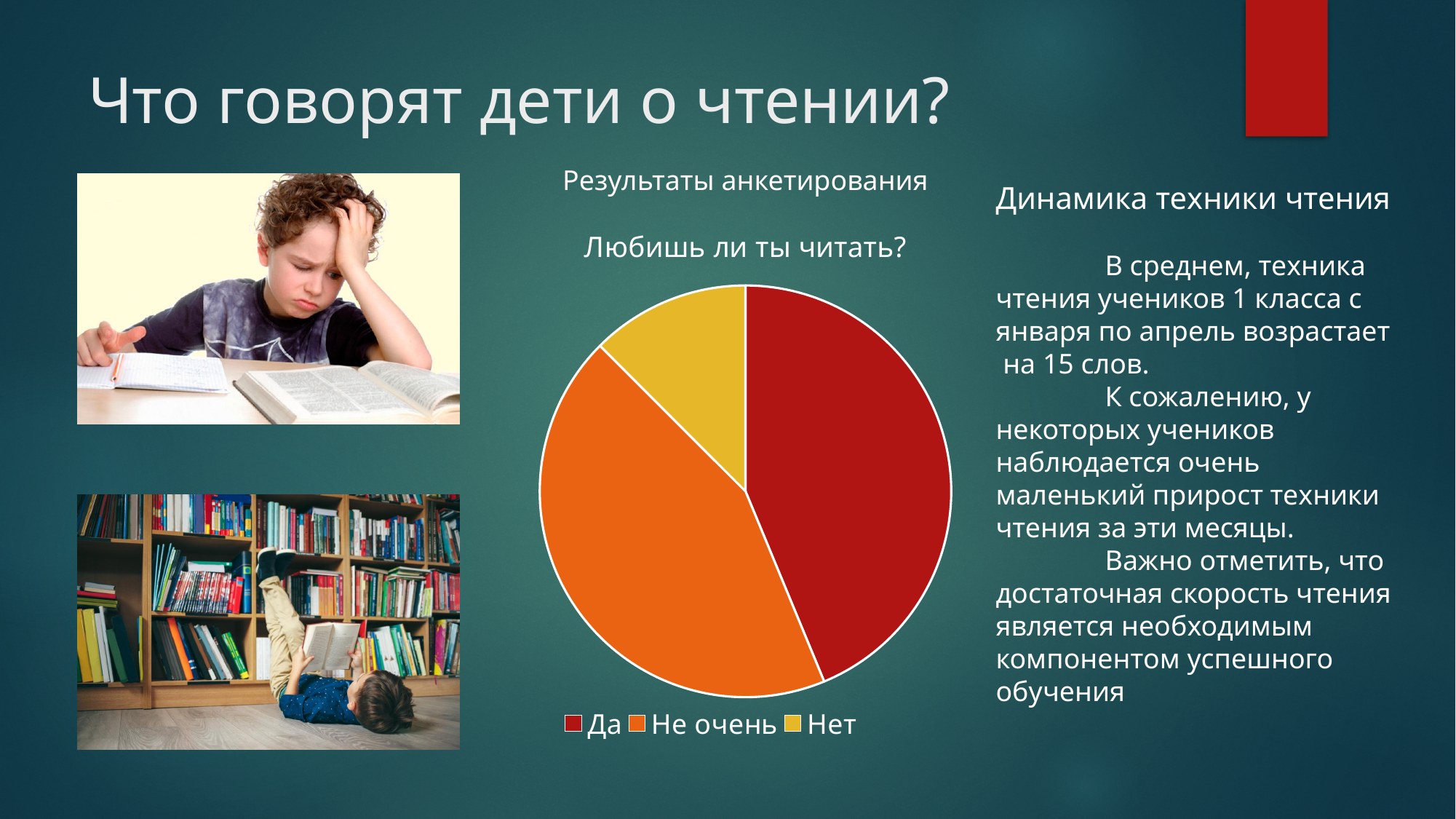
Which legend entry of the pie chart is shown in yellow? Нет Which legend entry of the pie chart is shown in dark red? Да What is the title of the pie chart? Любишь ли ты читать? Which slice is larger in the pie chart, Не очень or Нет? Не очень How many slices does the pie chart have? 3 What kind of chart is shown on the slide? pie chart How many entries does the legend of the pie chart list? 3 Which category has the smallest slice in the pie chart? Нет Which slice is larger in the pie chart, Да or Нет? Да